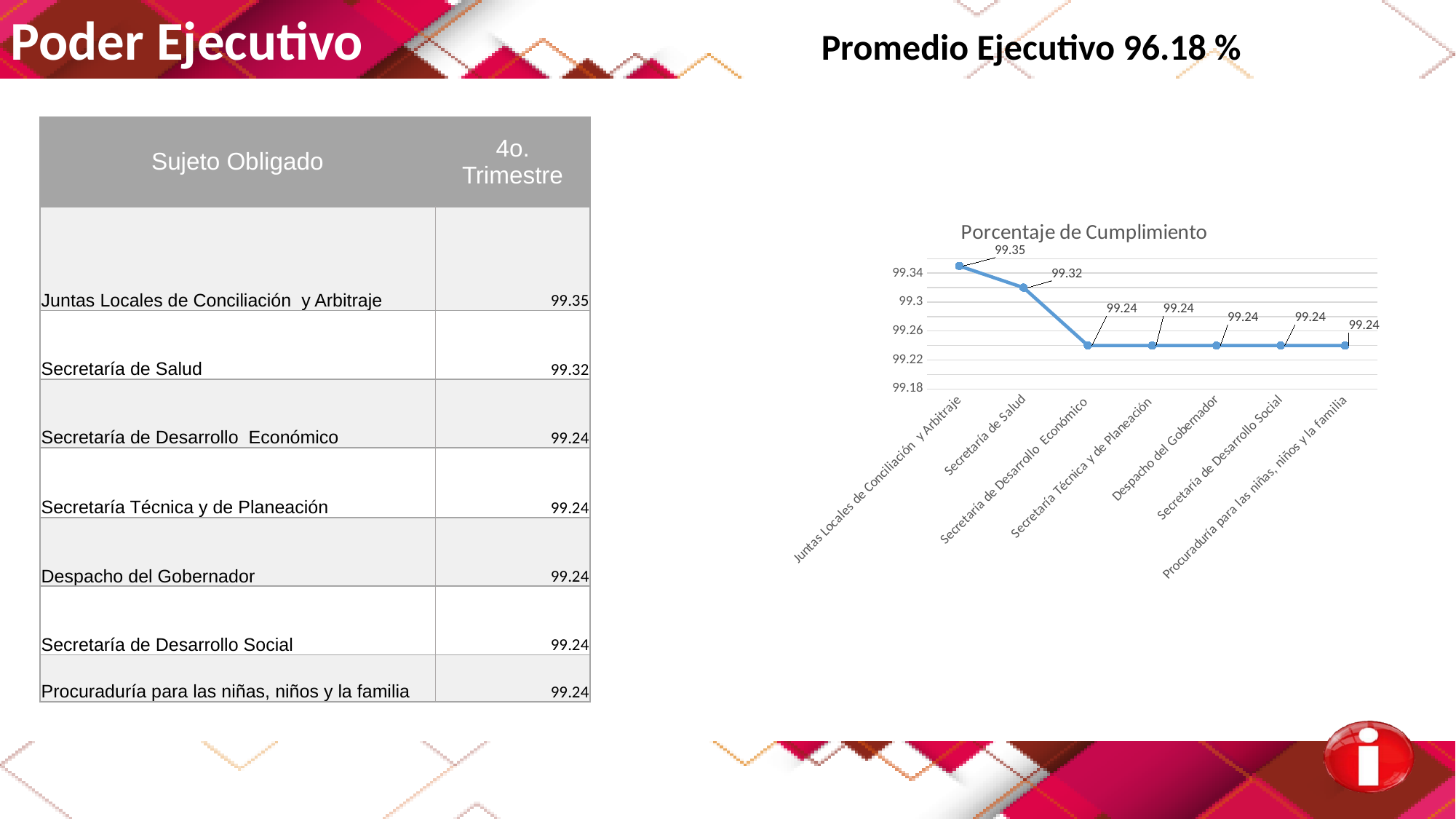
What is the value for Juntas Locales de Conciliación y Arbitraje in the chart? 99.35 Which is larger, the value for Secretaría de Salud or the value for Secretaría Técnica y de Planeación? Secretaría de Salud What type of chart is shown on the slide? line chart What is the title of the chart? Porcentaje de Cumplimiento What is the difference between the values for Juntas Locales de Conciliación y Arbitraje and Secretaría de Desarrollo Económico? 0.11 Which category has the highest value in the chart? Juntas Locales de Conciliación y Arbitraje What is the value for Secretaría de Salud in the chart? 99.32 Is the value for Procuraduría para las niñas, niños y la familia greater or less than 99.3? less Do the values in the chart generally rise or fall from left to right along the x axis? fall How many categories are plotted on the x axis of the chart? 7 What is the value for Despacho del Gobernador in the chart? 99.24 What is the difference between the values for Secretaría de Salud and Secretaría de Desarrollo Social? 0.08